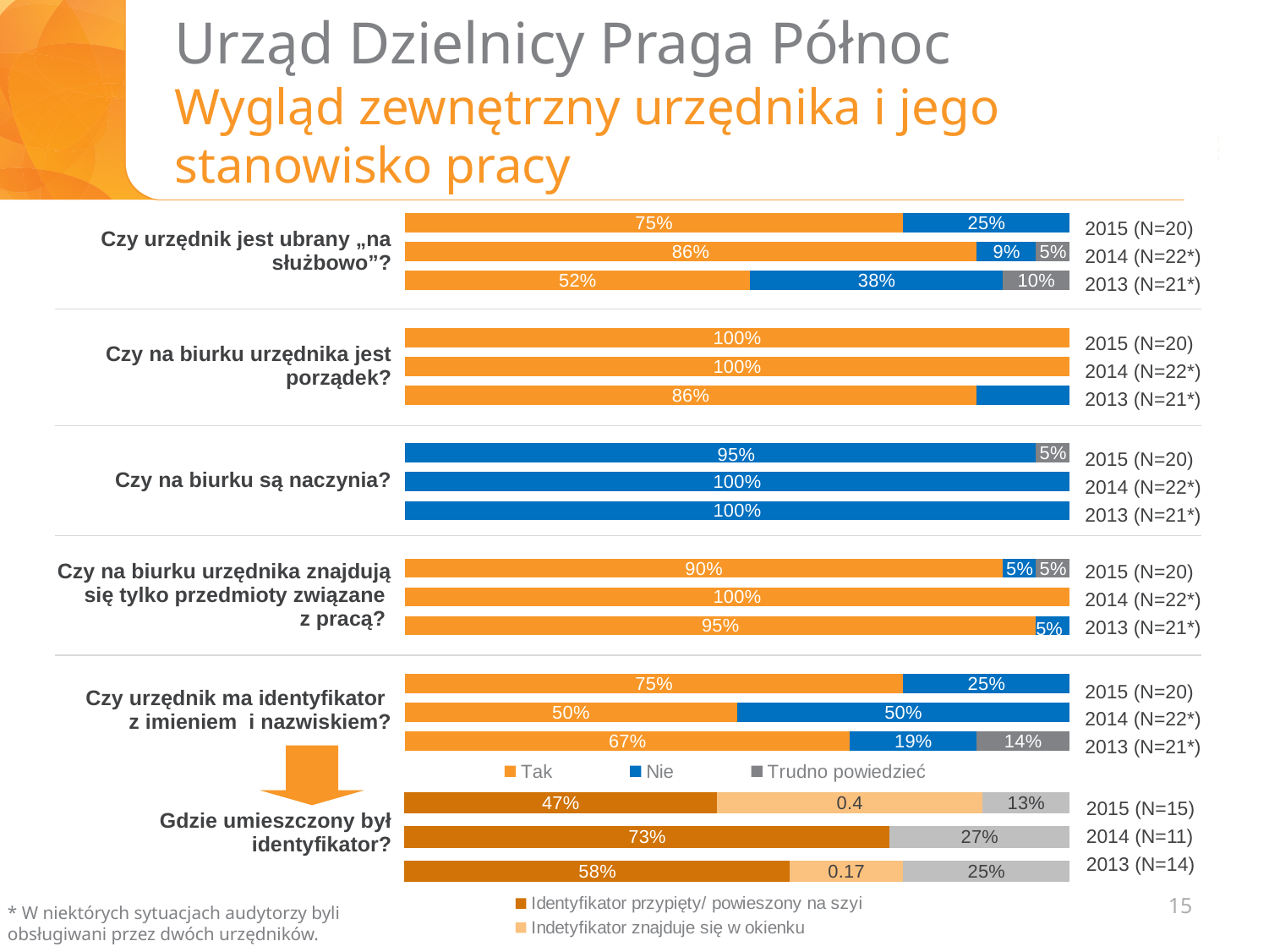
In the upper chart, for "Czy urzędnik ma identyfikator z imieniem i nazwiskiem?", which year has the larger "Tak" share: 2015 or 2014? 2015 In the upper chart, for "Czy na biurku są naczynia?", what is the "Nie" value for 2015 (N=20)? 95% In the upper chart, for the question "Czy urzędnik jest ubrany „na służbowo”?", what percentage answered "Tak" in 2015 (N=20)? 75% In the upper chart, for "Czy urzędnik jest ubrany „na służbowo”?", by how many percentage points does the "Tak" value for 2014 exceed the "Tak" value for 2013? 34 percentage points What kind of chart is used on this slide? Stacked bar chart In the lower chart "Gdzie umieszczony był identyfikator?", what is the value for "Indetyfikator znajduje się w okienku" in 2015 (N=15)? 0.4 In the lower chart "Gdzie umieszczony był identyfikator?", what is the value for "Identyfikator przypięty/ powieszony na szyi" in 2014 (N=11)? 73% In the upper chart, for "Czy urzędnik jest ubrany „na służbowo”?", which year has the highest "Tak" share? 2014 (N=22*) In the upper chart, for "Czy na biurku urzędnika jest porządek?", what is the "Tak" value for 2013 (N=21*)? 86% In the upper chart, for "Czy urzędnik ma identyfikator z imieniem i nazwiskiem?", what is the "Tak" value for 2013 (N=21*)? 67% In the upper chart, for "Czy urzędnik jest ubrany „na służbowo”?", what is the "Nie" value for 2013 (N=21*)? 38% How many series does the legend of the upper chart list? 3